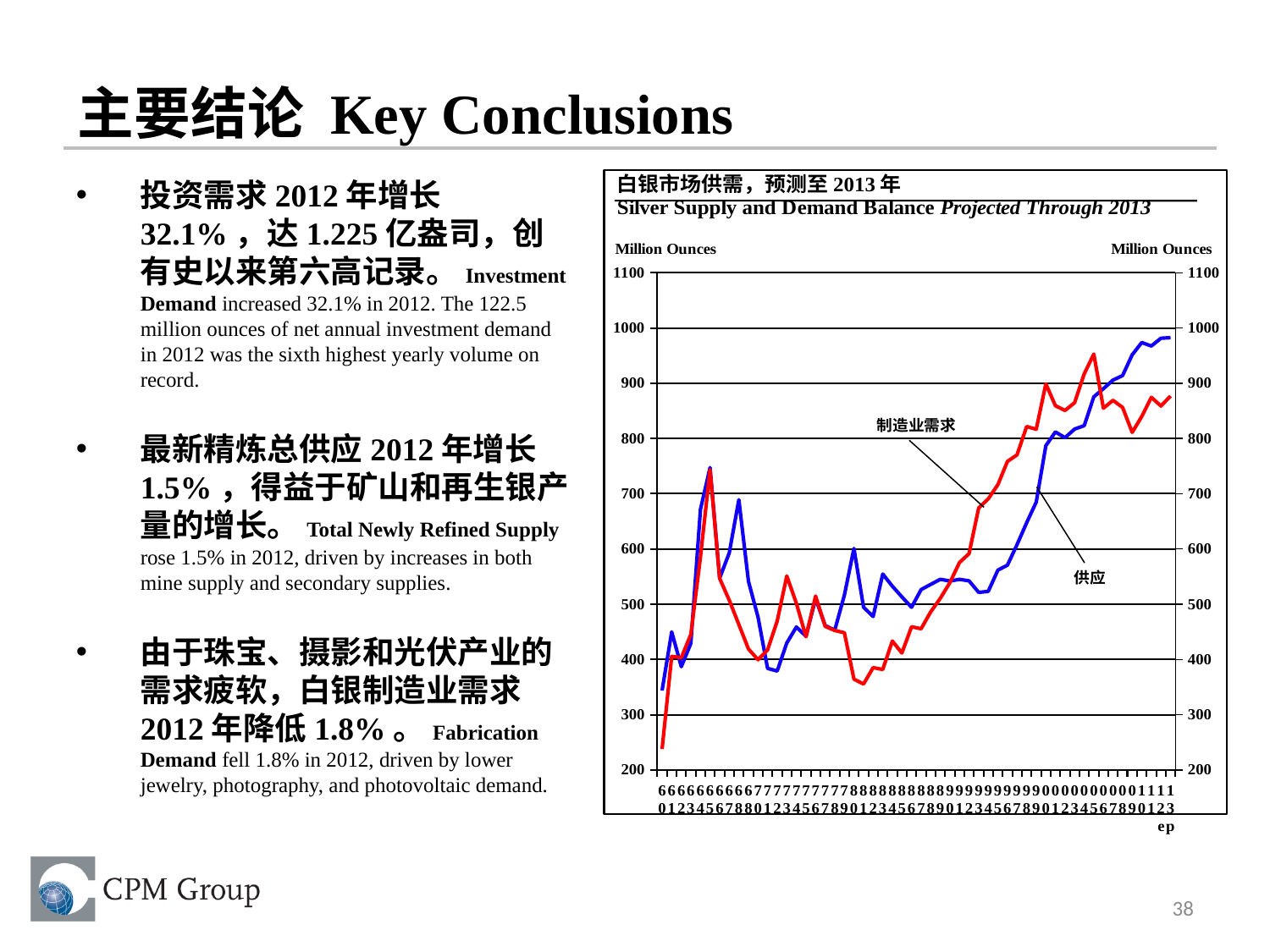
Overall, does the 供应 (supply) line rise or fall from 1960 to 2013? rise What is the English title of the chart? Silver Supply and Demand Balance Projected Through 2013 At the end of the chart (2013), which line is higher: 供应 (supply) or 制造业需求 (fabrication demand)? 供应 (supply) What kind of chart is shown on the slide? line chart Is the value of the 制造业需求 (fabrication demand) line at the start of the chart (1960) greater or less than 300? less How many lines (series) are plotted on the chart? 2 Is the value of the 供应 (supply) line at the start of the chart (1960) greater or less than 300? greater What unit is shown on the vertical axis of the chart? Million Ounces Is the value of the 制造业需求 (fabrication demand) line at the end of the chart (2013) greater or less than 900? less